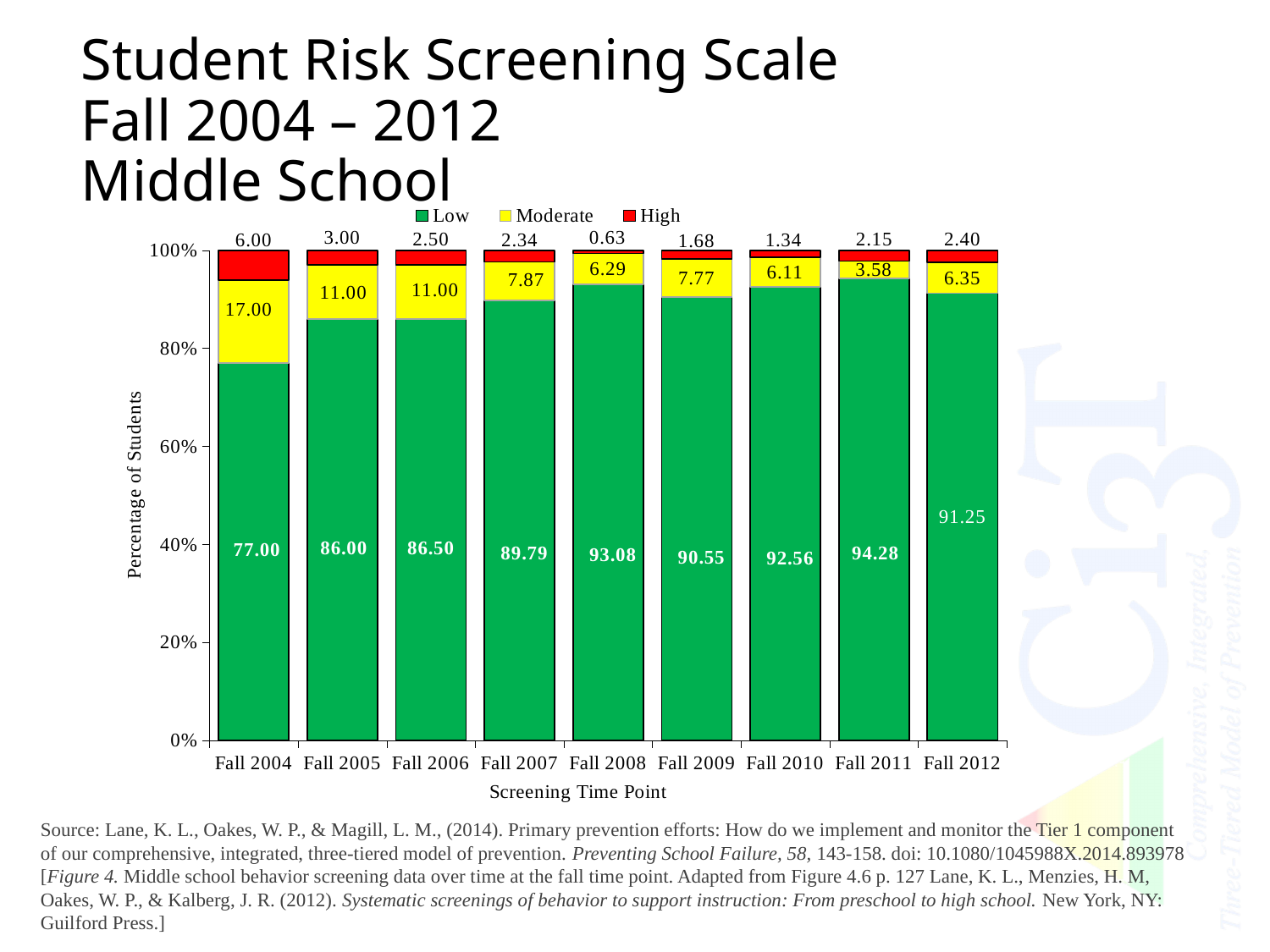
Which screening time point has the highest Moderate percentage? Fall 2004 What kind of chart is shown on the slide? Stacked bar chart What is the Moderate value for Fall 2007? 7.87 How many screening time points are shown on the x axis? 9 What is the High value for Fall 2008? 0.63 Do the High values rise or fall from Fall 2004 to Fall 2008? Fall What is the difference between the Low value in Fall 2012 and the Low value in Fall 2004? 14.25 What percentage of students were in the Low category in Fall 2004? 77.00 How many series does the legend list? 3 Which screening time point has the highest Low percentage? Fall 2011 Which is larger, the Low value for Fall 2009 or the Low value for Fall 2010? Fall 2010 Which screening time point has the lowest High percentage? Fall 2008